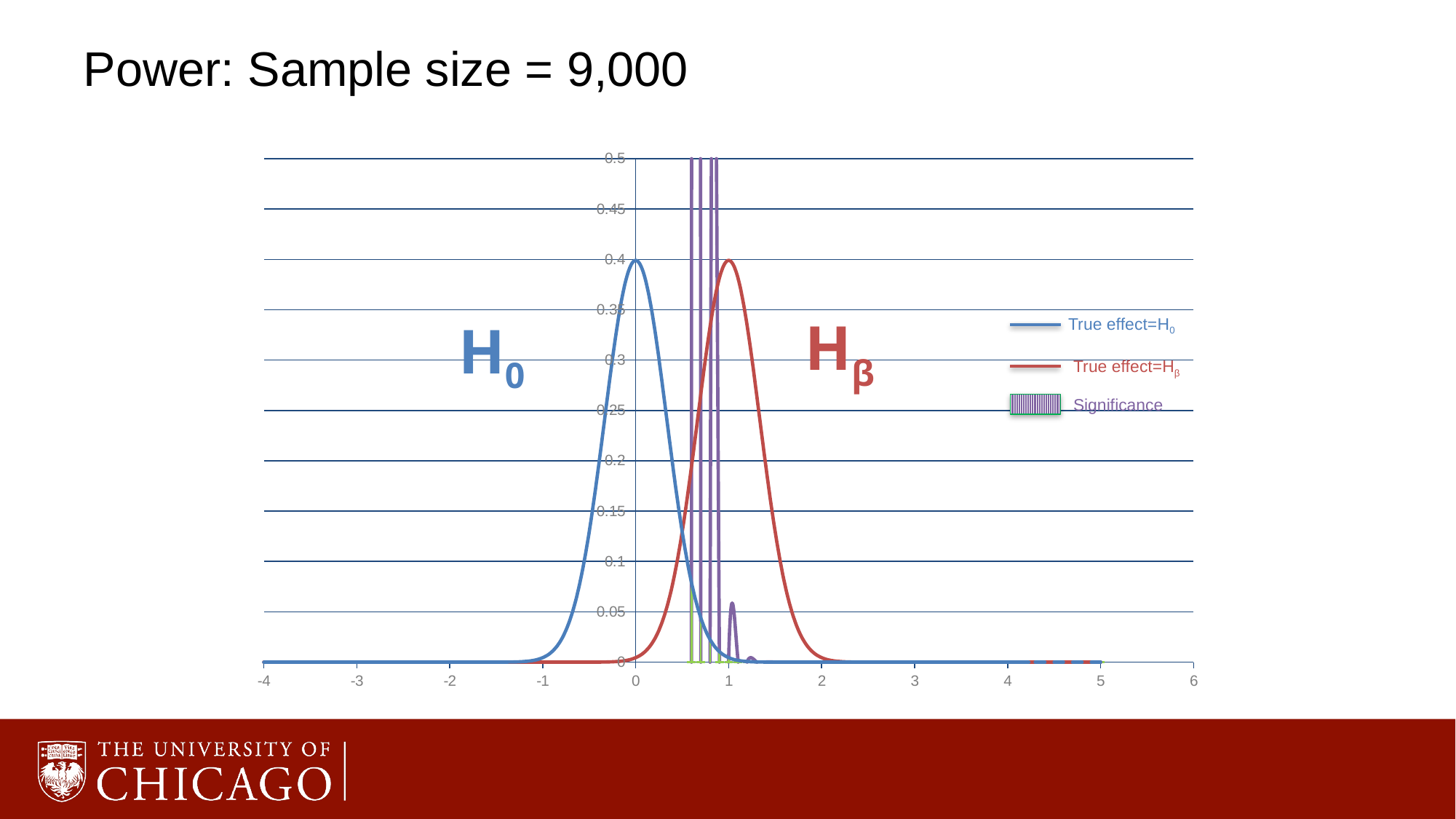
Is the value of the red True effect=Hβ curve at x = 0 greater or less than 0.05? less What is the title of the slide containing the chart? Power: Sample size = 9,000 What kind of chart is shown on the slide? line chart Does the blue True effect=H0 curve rise or fall as x goes from 0 to 2? fall At what x value does the red True effect=Hβ curve reach its peak? 1 At x = -0.5, which curve is higher, True effect=H0 or True effect=Hβ? True effect=H0 How many series does the legend list? 3 At x = 1.5, which curve is higher, True effect=H0 or True effect=Hβ? True effect=Hβ Is the peak value of the blue True effect=H0 curve greater or less than 0.3? greater At what x value does the blue True effect=H0 curve reach its peak? 0 Is the value of the blue True effect=H0 curve at x = 2 greater or less than 0.05? less Which legend entry is drawn in red? True effect=Hβ